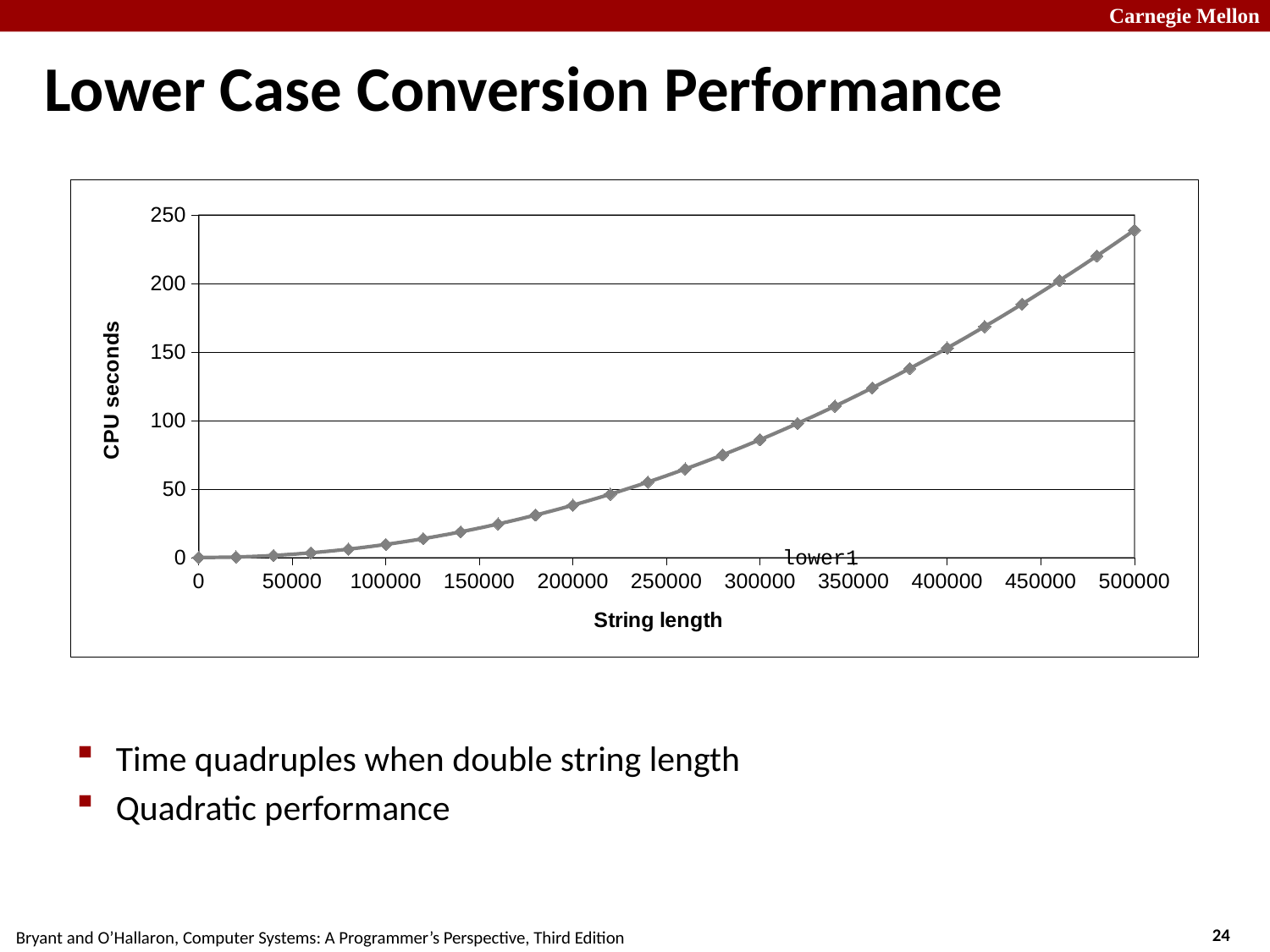
Is the CPU time at a string length of 400000 greater or less than 100? greater At which string length is the CPU time lowest? 0 Is the CPU time at a string length of 100000 greater or less than 50? less Is the CPU time at a string length of 200000 greater or less than 50? less What is the title of the x axis of the chart? String length Do the CPU seconds rise or fall as string length increases? rise At which string length is the CPU time highest? 500000 What kind of chart is shown on the slide? line chart Which has the larger CPU time: a string length of 100000 or a string length of 400000? 400000 What is the title of the y axis of the chart? CPU seconds